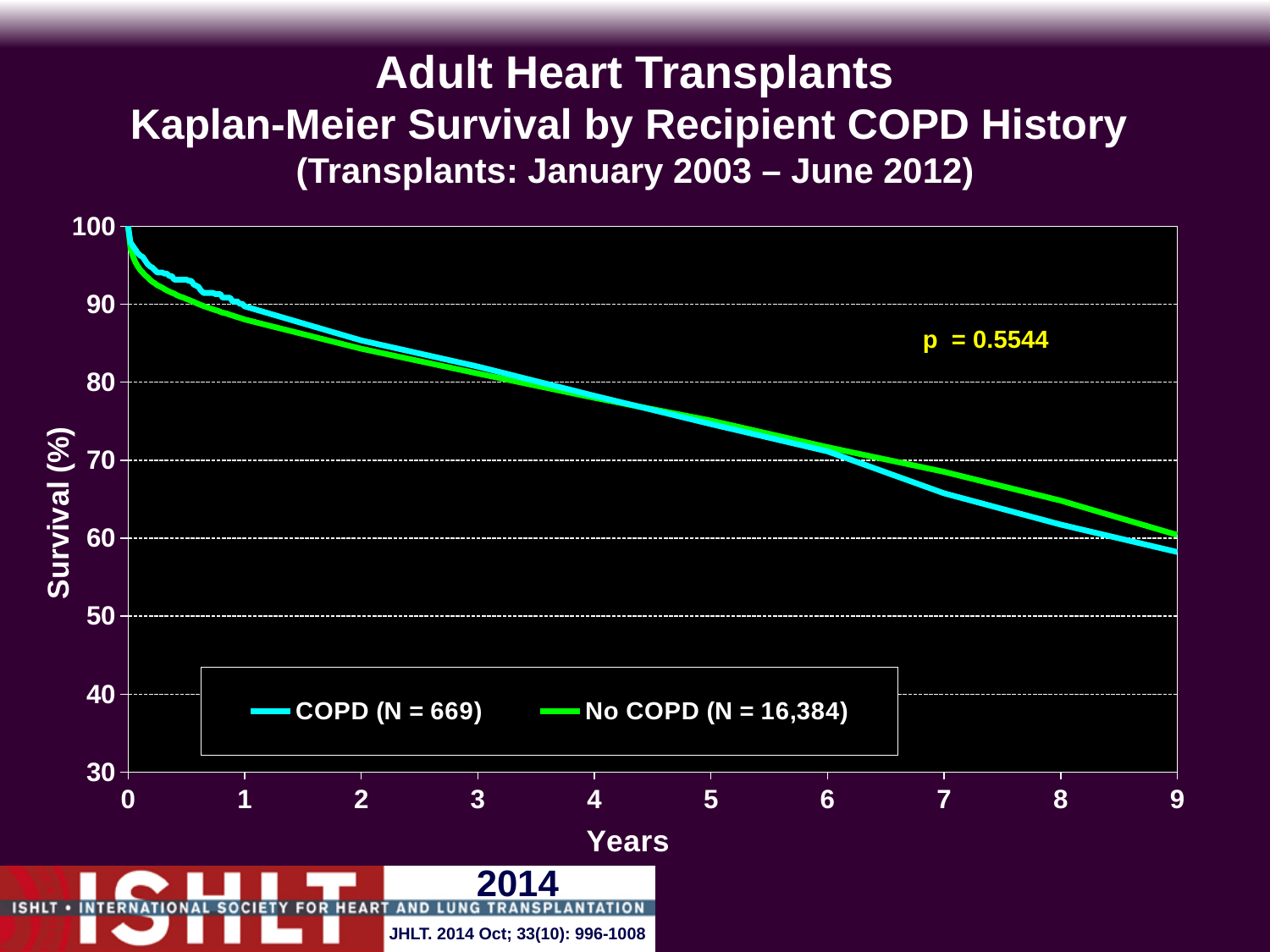
Is the survival value for No COPD at year 4 greater or less than 80? less What is the N for the No COPD group shown in the legend? 16,384 At year 8, which series has the lower survival, COPD or No COPD? COPD Is the survival value for COPD at year 7 greater or less than 60? greater How many series does the legend list? 2 At year 9, which series has the higher survival, COPD or No COPD? No COPD What kind of chart is shown on the slide? line chart Is the survival value for COPD at year 2 greater or less than 80? greater Do the survival curves rise or fall as years increase? fall What p-value is shown on the chart? p = 0.5544